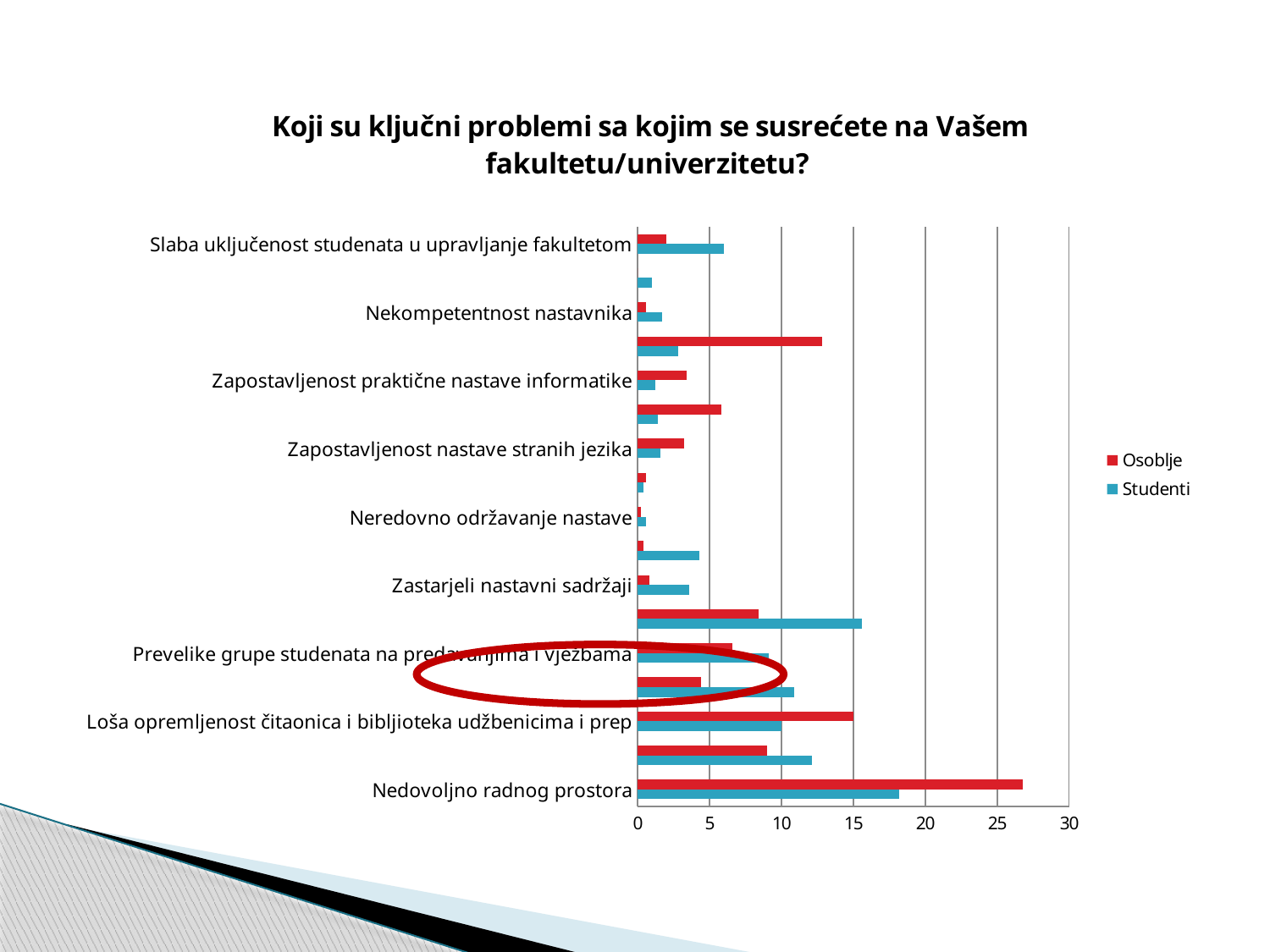
Is the Osoblje value for Nedovoljno radnog prostora greater or less than 25? greater For Nedovoljno radnog prostora, which series has the larger value, Osoblje or Studenti? Osoblje How many series does the legend list? 2 Which series is shown in red in the legend? Osoblje Which category has the highest value for Studenti? Nedovoljno radnog prostora Is the Osoblje value for Loša opremljenost čitaonica i biblioteka udžbenicima i prep greater or less than 10? greater For Zastarjeli nastavni sadržaji, which series has the larger value, Osoblje or Studenti? Studenti Which category has the highest value for Osoblje? Nedovoljno radnog prostora Is the Studenti value for Nedovoljno radnog prostora greater or less than 20? less What kind of chart is shown on the slide? bar chart For Slaba uključenost studenata u upravljanje fakultetom, which series has the larger value, Osoblje or Studenti? Studenti What is the maximum value shown on the horizontal axis? 30